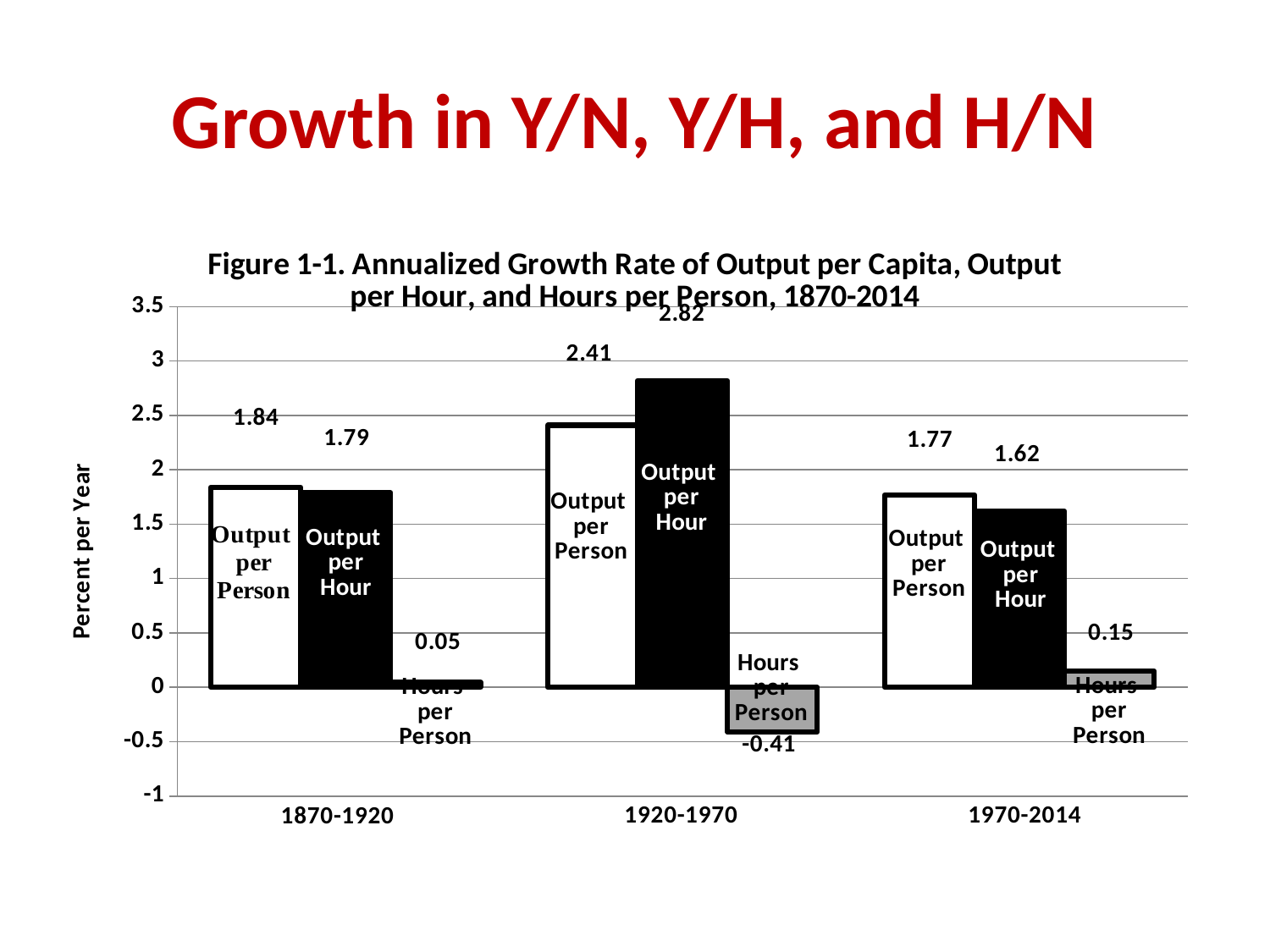
What is the difference between Output per Hour and Output per Person in 1920-1970? 0.41 Which period has the highest Output per Hour growth rate? 1920-1970 What is the value for Hours per Person in 1920-1970? -0.41 How many time periods are shown on the x axis? 3 What is the value for Hours per Person in 1970-2014? 0.15 In 1970-2014, which is larger: Output per Person or Output per Hour? Output per Person Which period has the lowest Hours per Person value? 1920-1970 What is the label of the y axis? Percent per Year What kind of chart is shown on the slide? bar chart What is the value for Output per Person in 1870-1920? 1.84 Is the value for Output per Hour in 1920-1970 greater or less than 2.5? greater What is the annualized growth rate of Output per Hour for 1920-1970? 2.82